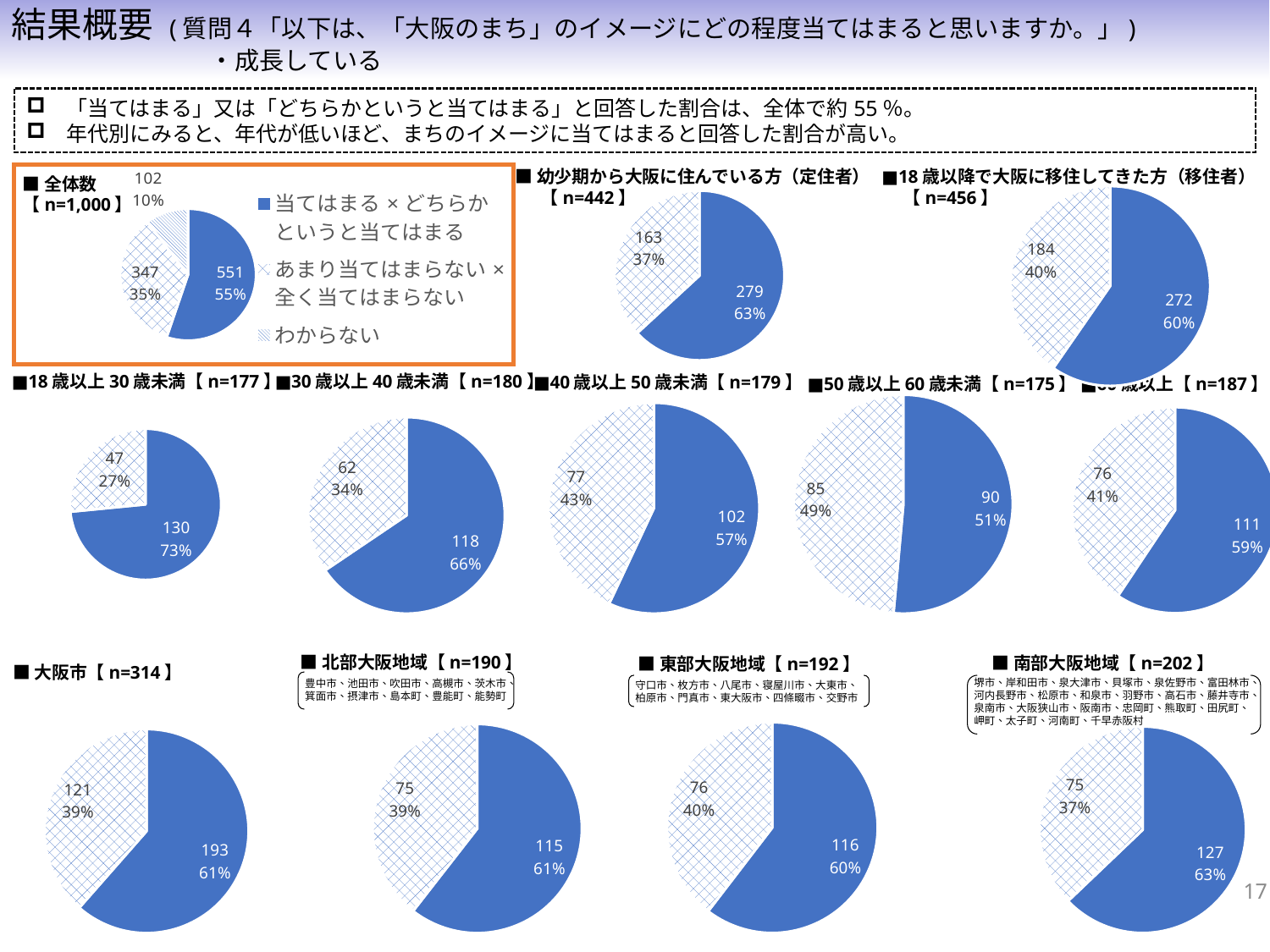
In the 18歳以降で大阪に移住してきた方（移住者）(n=456) pie chart, what is the count for the smaller slice? 184 What kind of chart is used for the 幼少期から大阪に住んでいる方（定住者） data? pie chart In the 幼少期から大阪に住んでいる方（定住者）(n=442) pie chart, what percentage is shown for the larger slice? 63% In the 全体数 (n=1,000) pie chart, what share of the pie is わからない? 10% How many slices does the 全体数 (n=1,000) pie chart have? 3 In the 18歳以上30歳未満 (n=177) pie chart, what is the difference between the two slice counts (130 and 47)? 83 In the 南部大阪地域 (n=202) pie chart, what percentage is shown for the slice with count 127? 63% In the 全体数 (n=1,000) pie chart, what is the count for 当てはまる × どちらかというと当てはまる? 551 In the 50歳以上60歳未満 (n=175) pie chart, what percentage is shown for the slice with count 85? 49% Which pie chart among the age-group charts shows the highest percentage for the larger slice: 18歳以上30歳未満 or 50歳以上60歳未満? 18歳以上30歳未満 How many entries does the legend next to the 全体数 pie chart list? 3 In the 大阪市 (n=314) pie chart, what is the count for the larger slice? 193